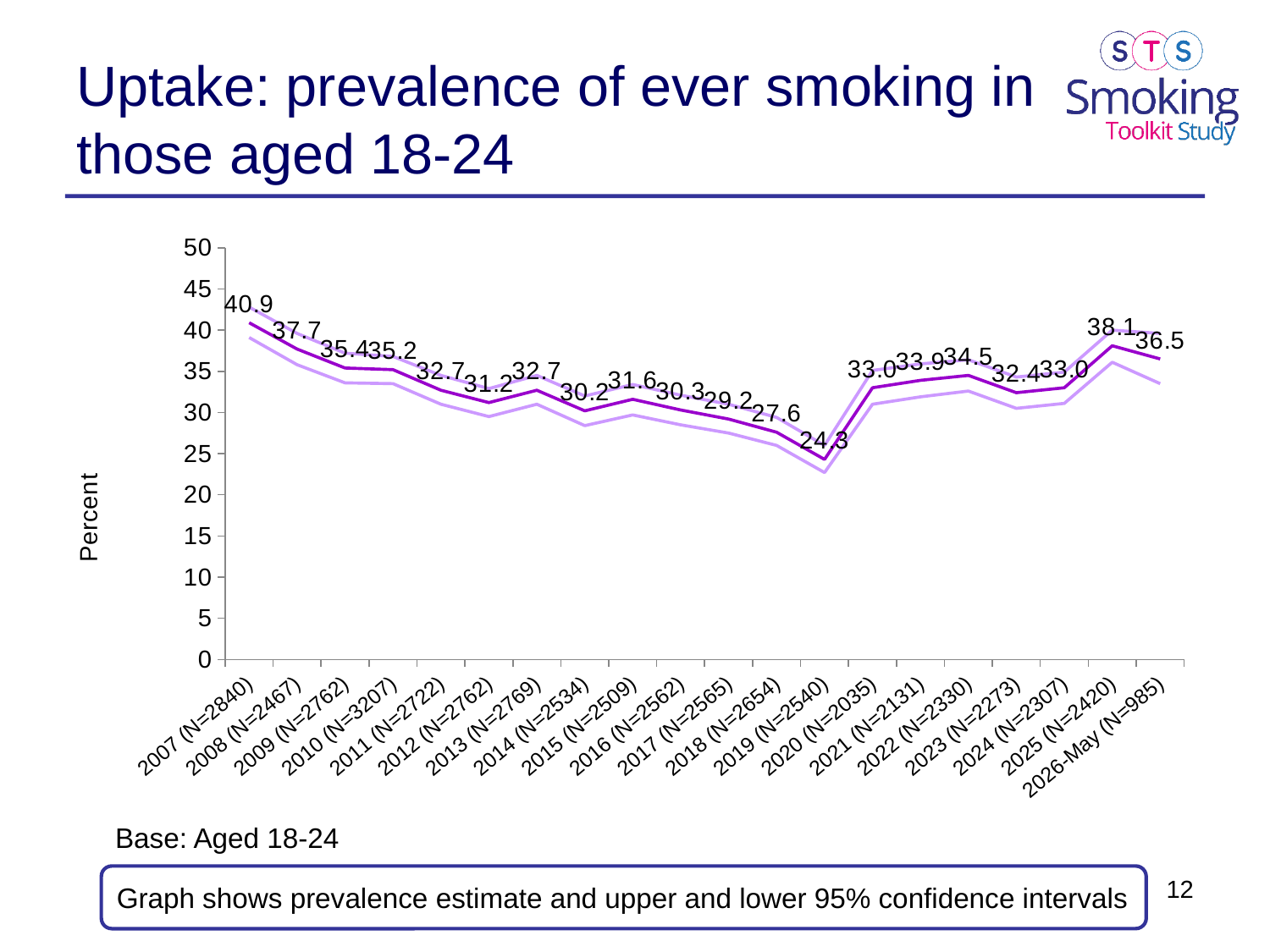
What is the prevalence estimate for 2025 (N=2420)? 38.1 What is the difference between the prevalence estimates for 2007 and 2019? 16.6 What kind of chart is shown on the slide? Line chart How many time points are plotted on the x axis? 20 Does the prevalence estimate generally rise or fall from 2007 to 2019? Fall Which has the higher prevalence estimate, 2025 (N=2420) or 2026-May (N=985)? 2025 (N=2420) What is the prevalence estimate for 2019 (N=2540)? 24.3 What is the prevalence estimate for 2007 (N=2840)? 40.9 By how much did the prevalence estimate rise from 2019 to 2020? 8.7 Which year has the lowest prevalence estimate? 2019 (N=2540) What is the label on the y axis? Percent Which year has the highest prevalence estimate? 2007 (N=2840)